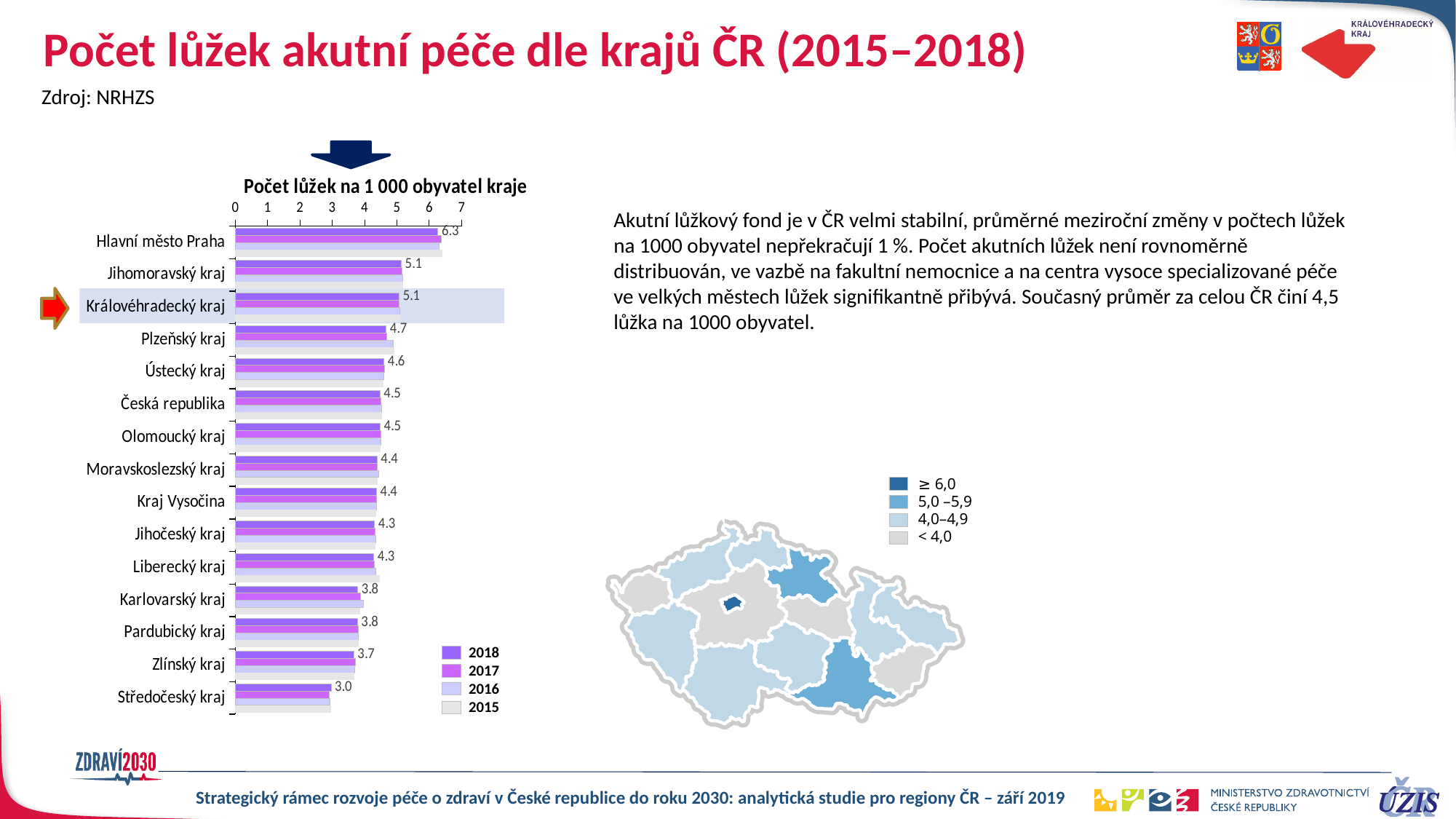
Which region has the highest 2018 value in the chart? Hlavní město Praha What kind of chart is shown on the left of the slide? bar chart What is the difference between the 2018 values for Hlavní město Praha and Středočeský kraj? 3.3 What is the 2018 value for Hlavní město Praha in the chart 'Počet lůžek na 1 000 obyvatel kraje'? 6.3 How many categories are shown on the vertical axis of the bar chart? 15 How many series does the legend of the bar chart list? 4 Which has a larger 2018 value, Plzeňský kraj or Zlínský kraj? Plzeňský kraj What is the 2018 value for Středočeský kraj in the chart? 3.0 What is the 2018 value for Královéhradecký kraj in the chart? 5.1 Which region has the lowest 2018 value in the chart? Středočeský kraj What is the title of the bar chart? Počet lůžek na 1 000 obyvatel kraje Is the 2018 value for Karlovarský kraj greater or less than 4? less